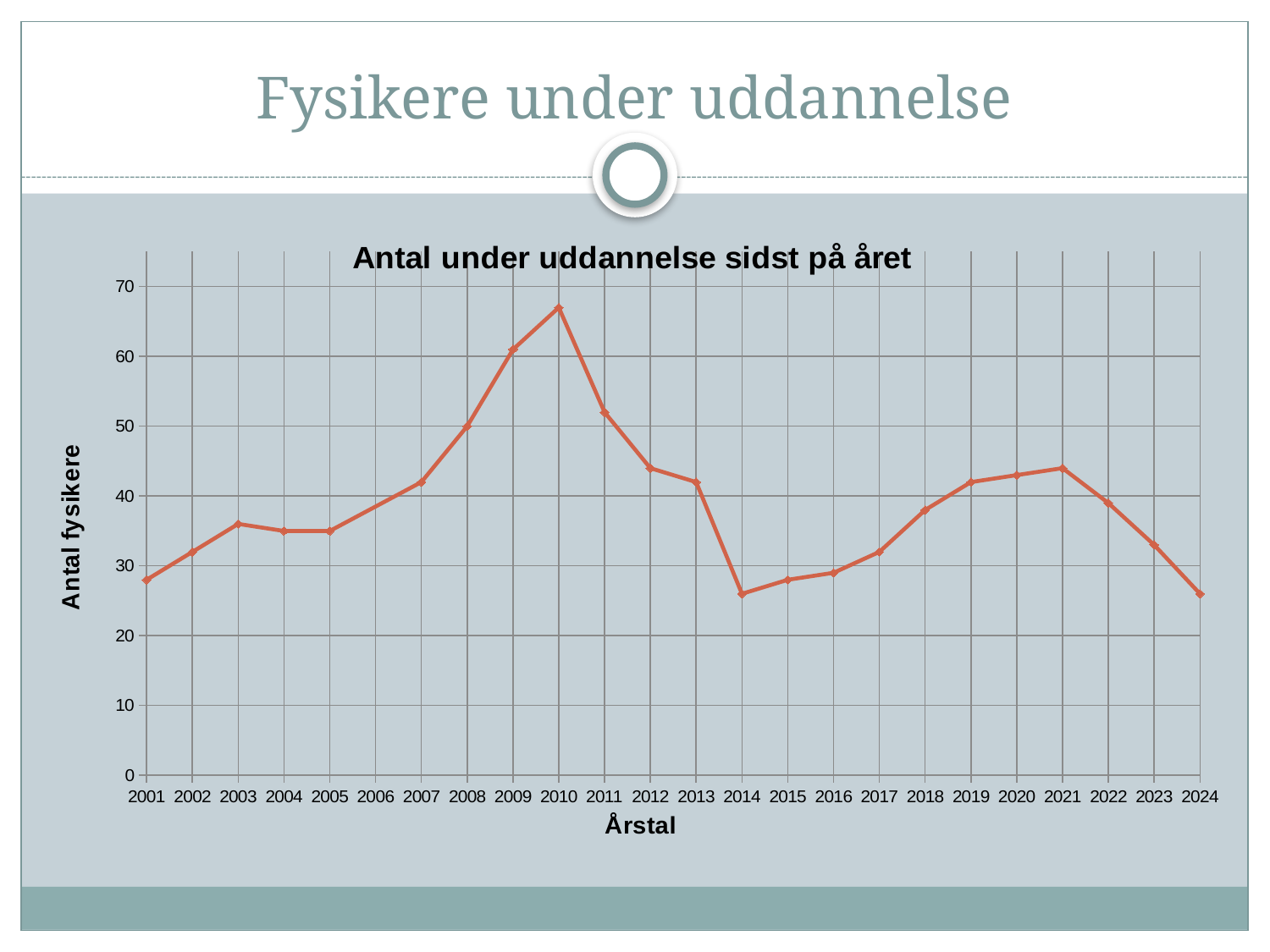
What is the label of the vertical axis? Antal fysikere Which year has the larger value, 2021 or 2024? 2021 Which year has the larger value, 2010 or 2014? 2010 What is the title of the chart? Antal under uddannelse sidst på året What kind of chart is shown on the slide? line chart Is the value for 2014 greater or less than 30? less Do the values rise or fall from 2010 to 2014? fall Is the value for 2010 greater or less than 60? greater Is the value for 2011 greater or less than 50? greater How many years are plotted along the x axis? 24 In which year is the number of physicists under education highest? 2010 What is the value for 2008? 50